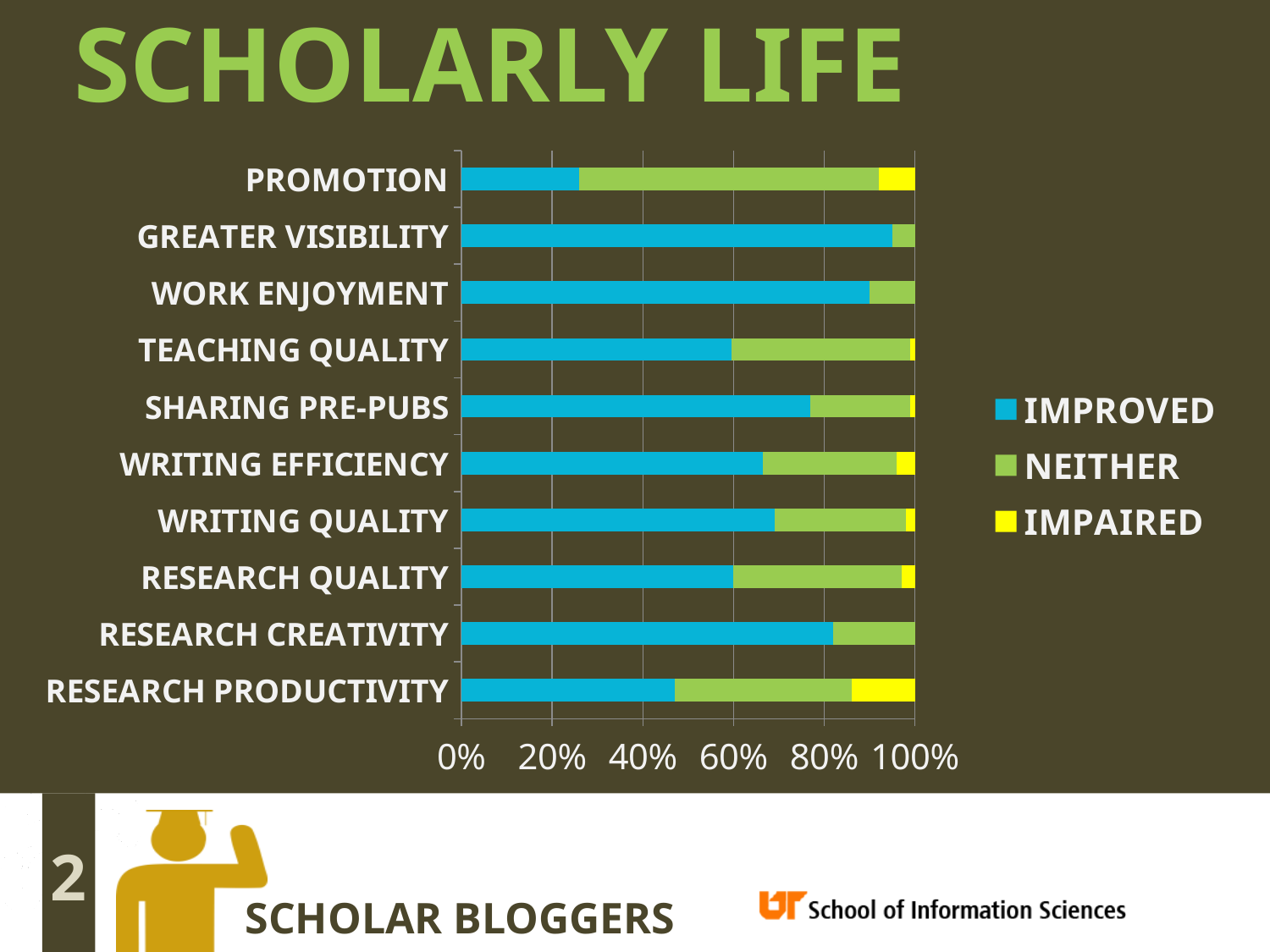
How many categories are plotted on the chart? 10 Which has the larger IMPROVED share, WORK ENJOYMENT or RESEARCH PRODUCTIVITY? WORK ENJOYMENT Is the IMPROVED value for RESEARCH PRODUCTIVITY greater or less than 60%? less What is the title of the chart on the slide? SCHOLARLY LIFE Is the IMPROVED value for GREATER VISIBILITY greater or less than 80%? greater Is the IMPROVED value for WRITING EFFICIENCY greater or less than 60%? greater Which category has the largest IMPAIRED share? RESEARCH PRODUCTIVITY Which category has the smallest IMPROVED share? PROMOTION What kind of chart is shown on the slide? bar chart How many series does the legend list? 3 Which category has the largest IMPROVED share? GREATER VISIBILITY